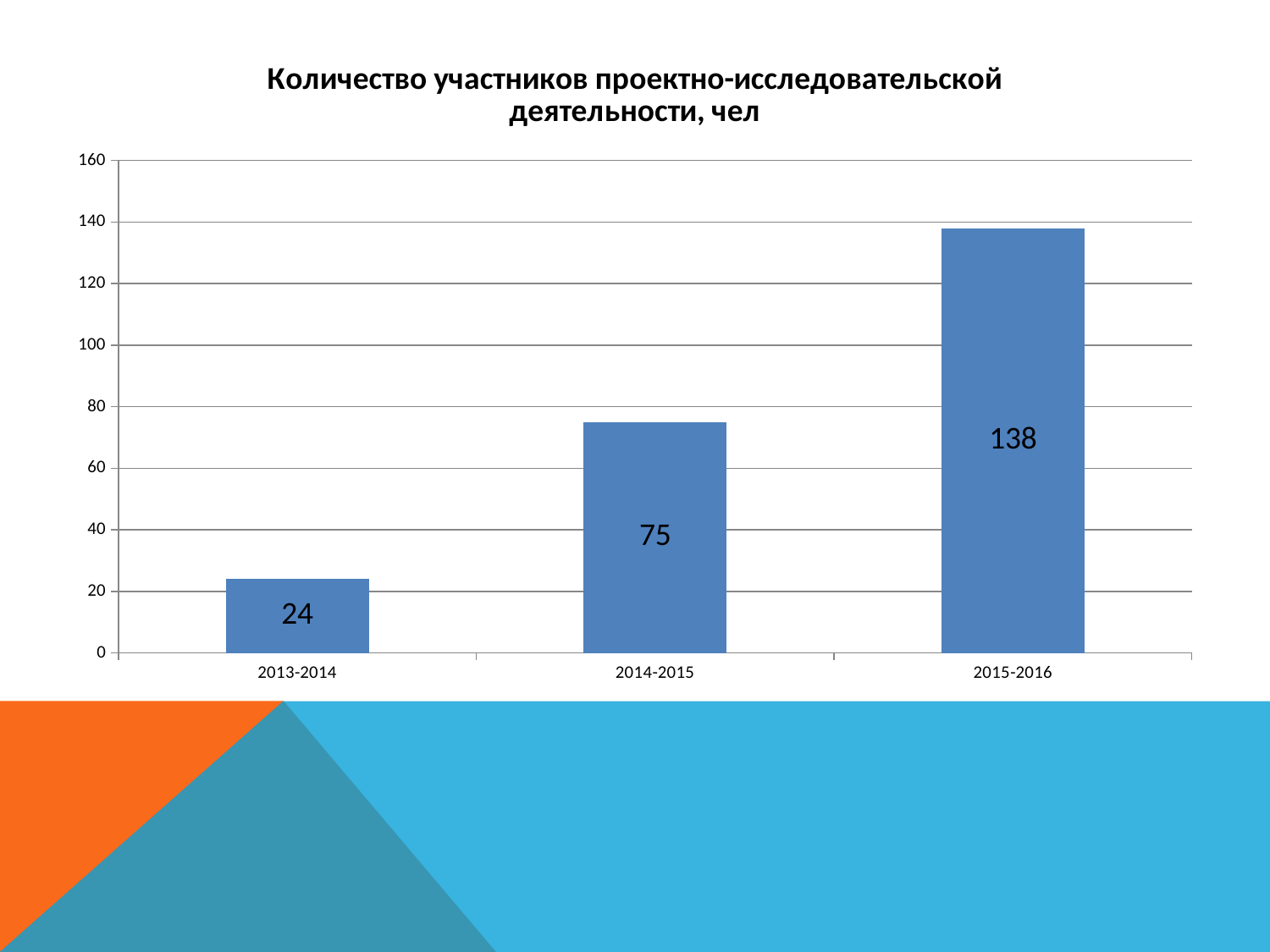
Do the values rise or fall from 2013-2014 to 2015-2016? rise What is the difference between the values for 2015-2016 and 2014-2015? 63 What is the difference between the values for 2014-2015 and 2013-2014? 51 Which category has the highest value? 2015-2016 What is the value for 2015-2016? 138 What kind of chart is shown on the slide? bar chart Is the value for 2015-2016 greater or less than 120? greater Which category has the lowest value? 2013-2014 How many categories are shown on the x axis? 3 Which is larger, the value for 2014-2015 or the value for 2013-2014? 2014-2015 What is the value for 2013-2014? 24 What is the value for 2014-2015? 75